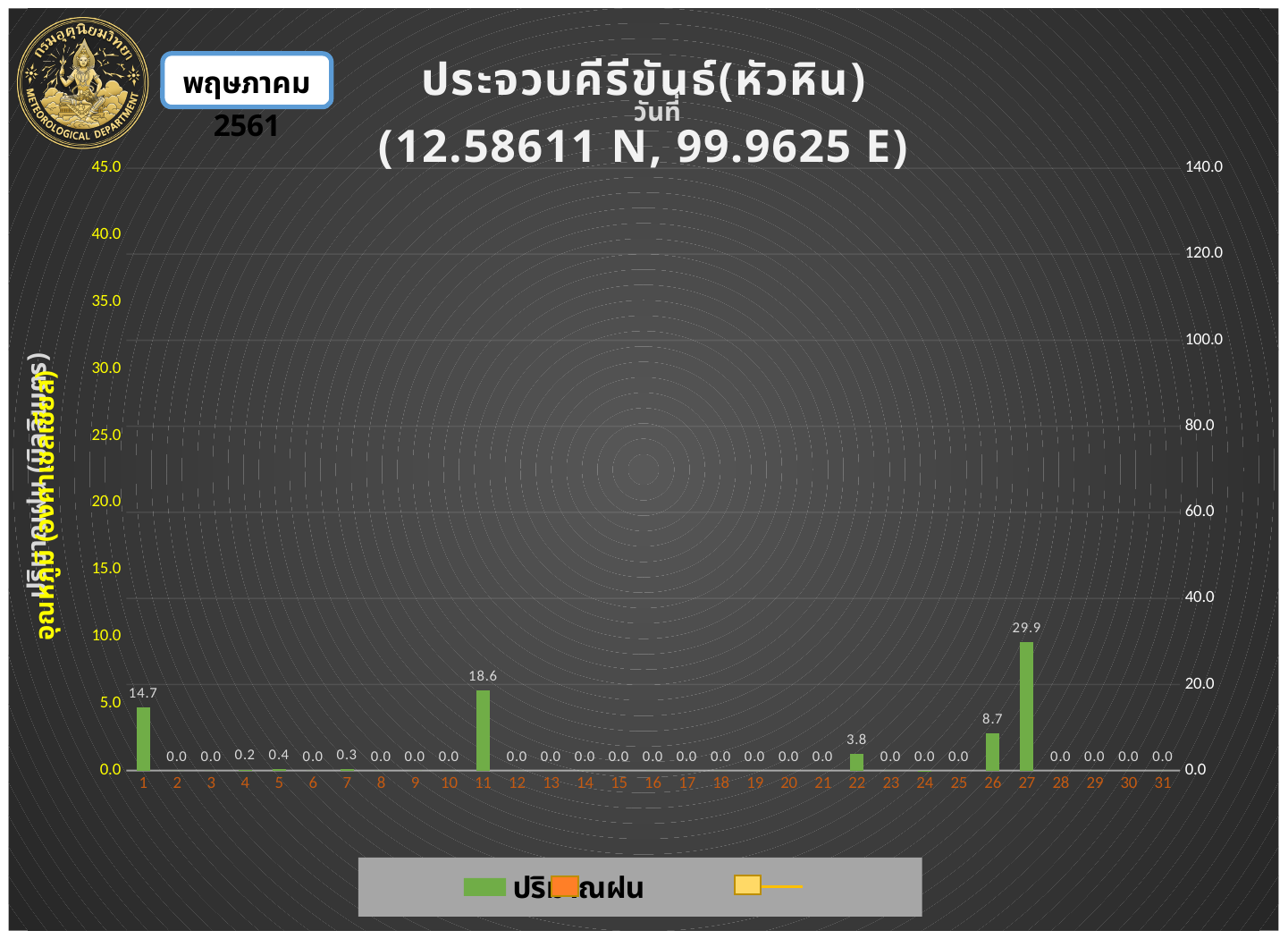
What kind of chart is used to show the rainfall values? bar chart Which day has the highest rainfall value? 27 What is the rainfall value shown for day 1? 14.7 What station name appears in the chart title? ประจวบคีรีขันธ์(หัวหิน) What is the difference between the rainfall values for day 1 and day 26? 6.0 What is the rainfall value shown for day 22? 3.8 What is the difference between the rainfall values for day 27 and day 11? 11.3 What is the rainfall value shown for day 11? 18.6 What is the rainfall value shown for day 26? 8.7 Which has the larger rainfall value, day 1 or day 22? day 1 How many days are shown on the x axis? 31 What is the rainfall value shown for day 27? 29.9